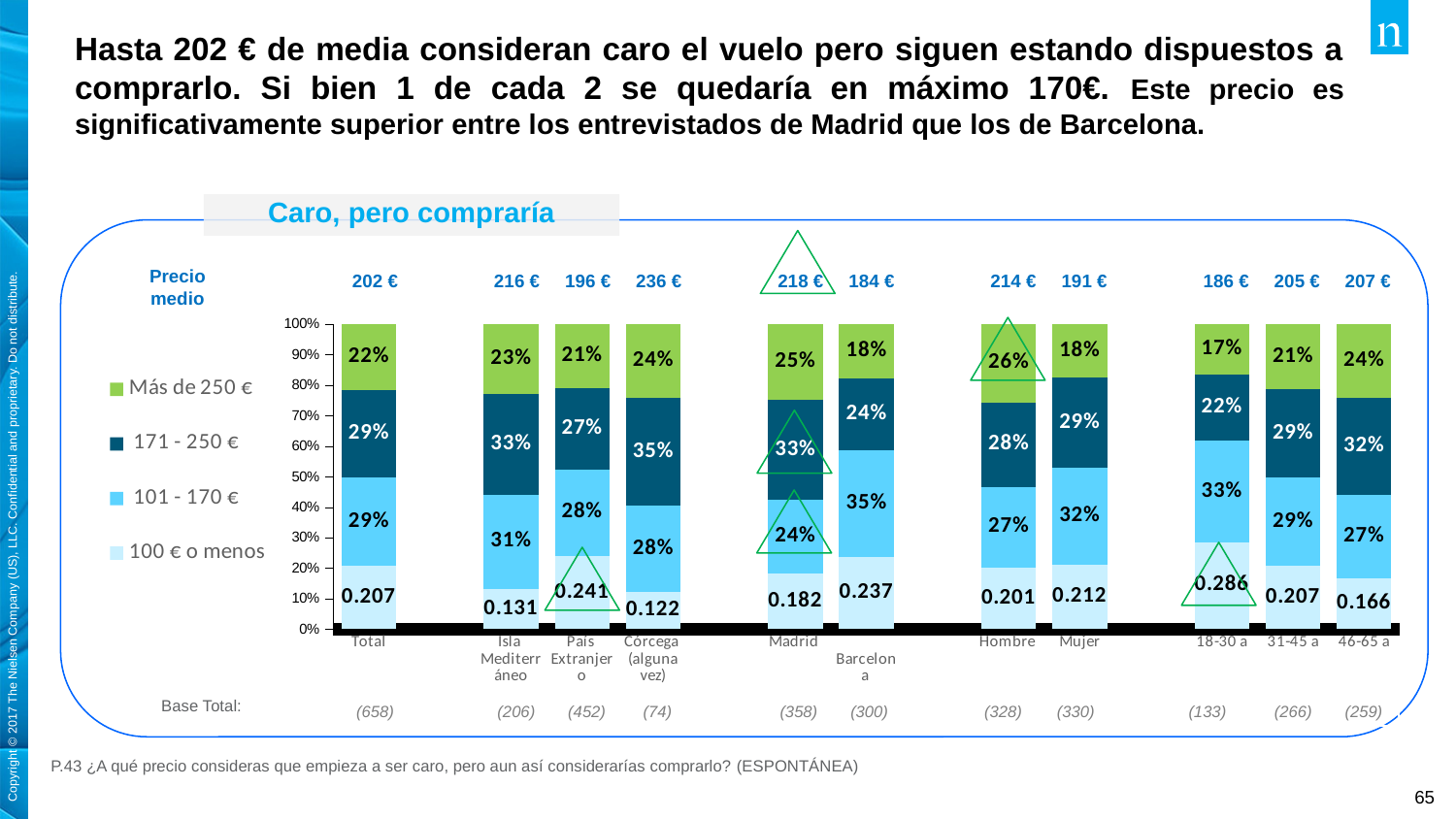
What kind of chart is shown on the slide? Stacked bar chart Which has a larger '171 - 250 €' segment, Hombre or Mujer? Mujer Which category has the highest 'Más de 250 €' percentage? Hombre Which category has the lowest 'Más de 250 €' percentage? 18-30 a What 'Precio medio' is shown above the Madrid bar? 218 € How many series does the legend list? 4 What is the value of the '101 - 170 €' segment for Barcelona? 35% How many categories (bars) are shown on the x axis? 11 What is the difference in the 'Más de 250 €' percentage between Madrid and Barcelona? 7 percentage points What percentage of the Madrid bar is in the 'Más de 250 €' segment? 25% What label is printed on the '100 € o menos' segment of the 18-30 a bar? 0.286 What is the value of the '171 - 250 €' segment for Córcega (alguna vez)? 35%